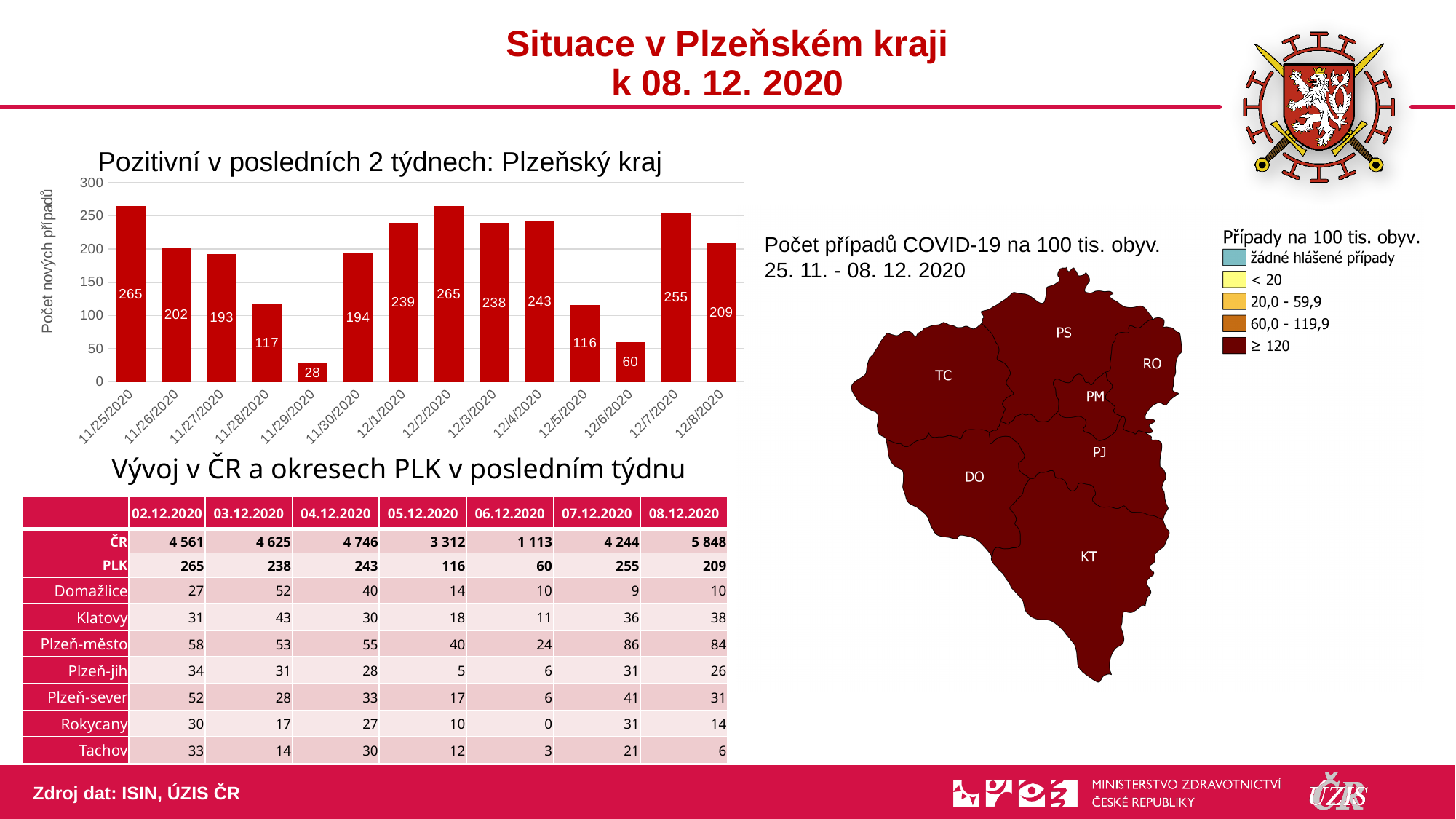
What type of chart is 'Pozitivní v posledních 2 týdnech: Plzeňský kraj'? bar chart Which date has the lowest value in the bar chart? 11/29/2020 Is the value for 12/4/2020 in the bar chart greater or less than 200? greater What is the highest value shown in the bar chart? 265 What is the y-axis label of the bar chart? Počet nových případů How many dates (bars) are shown in the bar chart? 14 What is the difference between the values for 12/5/2020 and 12/6/2020 in the bar chart? 56 Which is larger in the bar chart, the value for 11/26/2020 or the value for 11/30/2020? 11/26/2020 What is the value for 11/29/2020 in the chart 'Pozitivní v posledních 2 týdnech: Plzeňský kraj'? 28 What is the value for 12/7/2020 in the bar chart? 255 What is the difference between the values for 12/7/2020 and 12/8/2020 in the bar chart? 46 What is the value for 11/28/2020 in the bar chart? 117